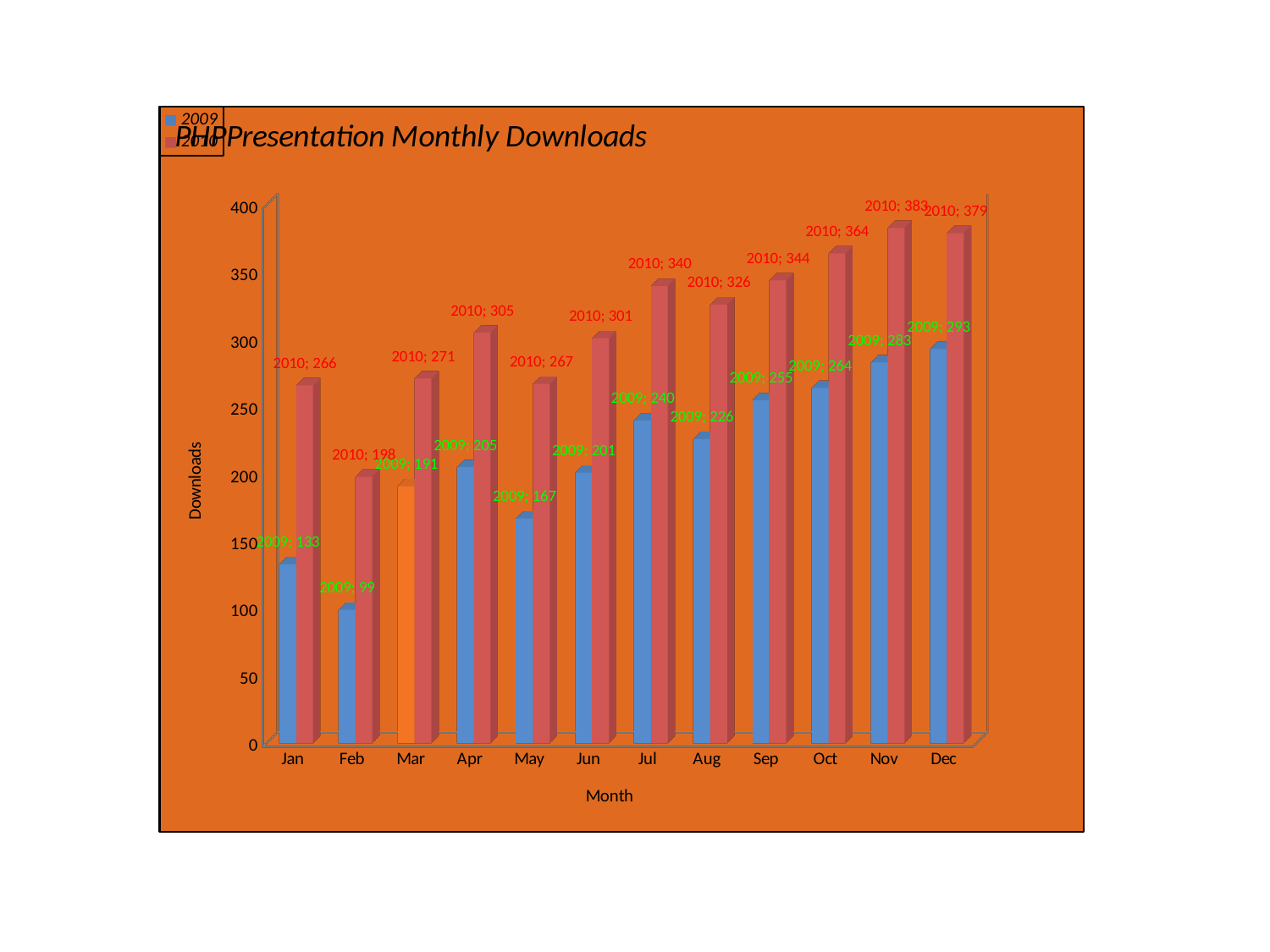
What is the 2009 value for Sep? 255 What is the 2009 value for Feb? 99 How many series does the legend list? 2 What is the difference between the 2010 and 2009 values for Jan? 133 How many months are shown on the x axis? 12 What is the label of the y axis? Downloads Which month has the lowest 2009 value? Feb Which is larger, the 2010 value for Nov or the 2010 value for Dec? 2010 value for Nov What is the 2010 value for Jul? 340 Do the 2010 values generally rise or fall from Jan to Dec? Rise Which month has the highest 2010 value? Nov What kind of chart is shown? Bar chart